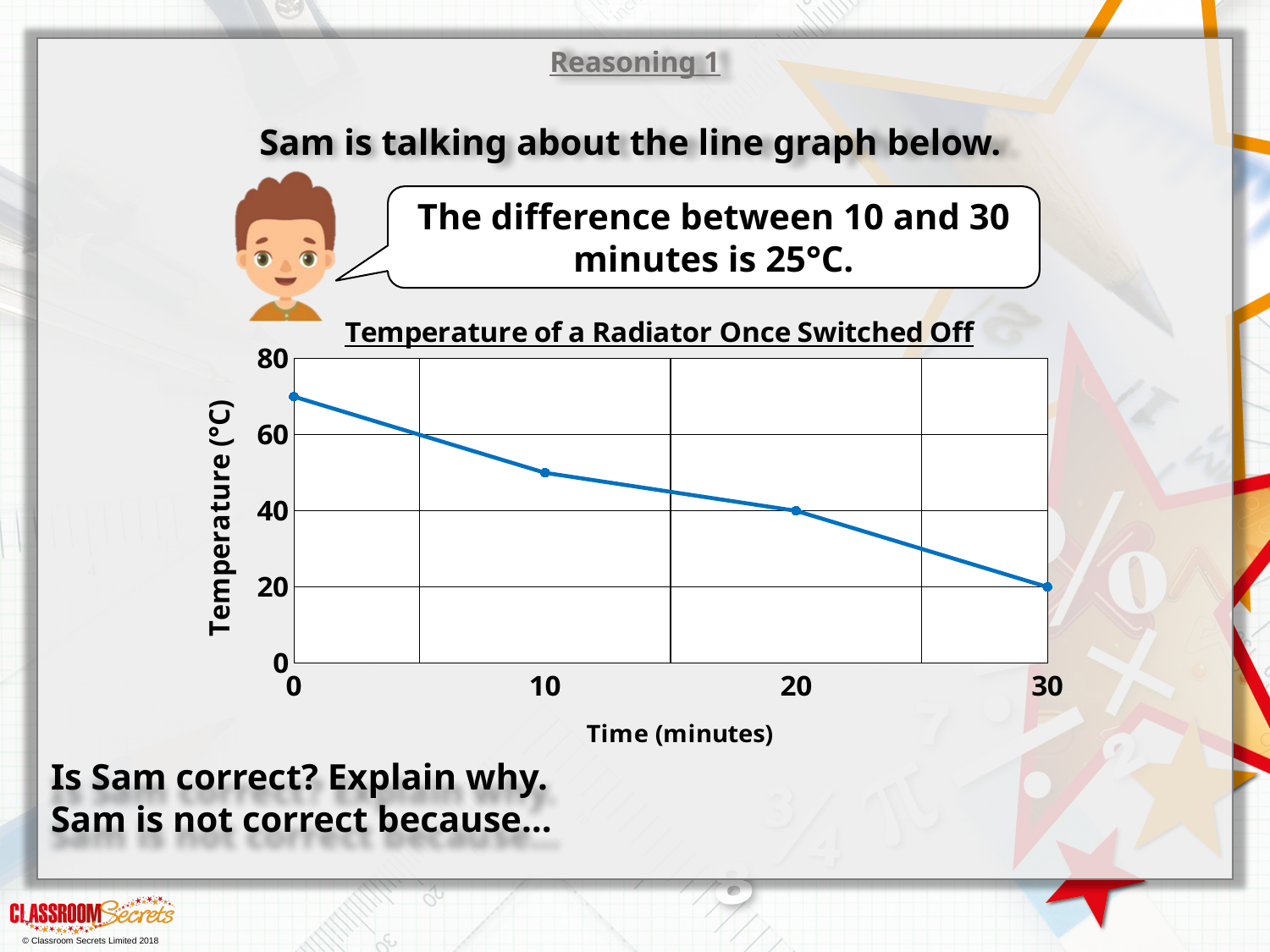
Which is higher, the temperature at 10 minutes or at 30 minutes? 10 minutes Is the temperature at 10 minutes greater or less than 60? less What is the difference in temperature between 20 minutes and 30 minutes? 20 What kind of chart is shown on the slide? line chart What is the title of the chart? Temperature of a Radiator Once Switched Off What is the temperature at 20 minutes? 40 At which time is the temperature highest? 0 minutes How many data points are plotted on the line? 4 Does the temperature rise or fall as time increases? fall What is the temperature at 30 minutes? 20 Is the temperature at 0 minutes greater or less than 60? greater At which time is the temperature lowest? 30 minutes